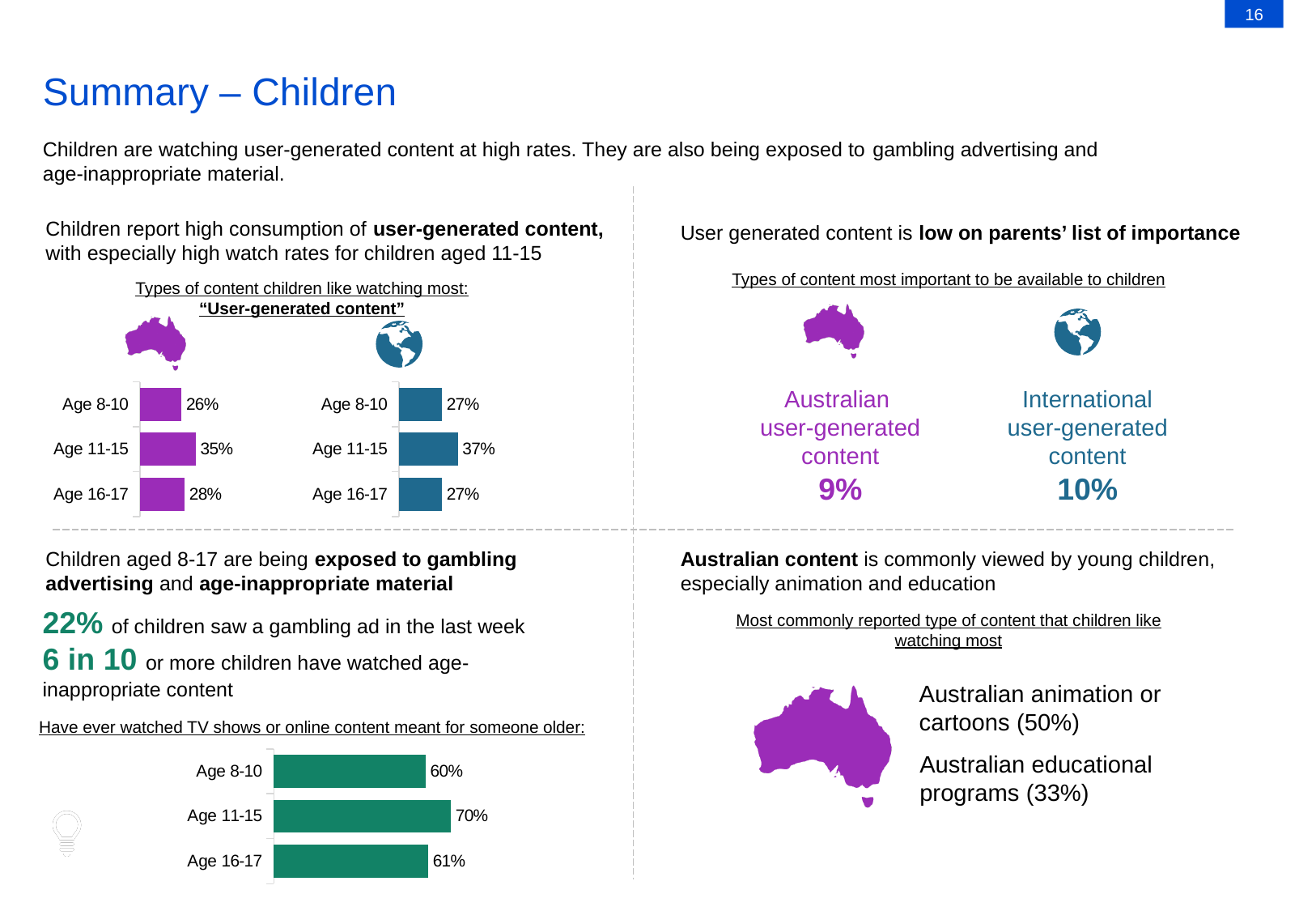
In the purple Australian user-generated content chart (top left), what is the difference between Age 11-15 and Age 8-10? 9 percentage points In the blue international user-generated content chart (top left), what is the value for Age 16-17? 27% In the blue international user-generated content chart (top left), which age group has the highest value? Age 11-15 In the 'Have ever watched TV shows or online content meant for someone older' chart (bottom left), which is larger, Age 16-17 or Age 8-10? Age 16-17 How many age groups are shown in the 'Have ever watched TV shows or online content meant for someone older' chart (bottom left)? 3 What kind of chart is the 'Have ever watched TV shows or online content meant for someone older' chart (bottom left)? Bar chart In the 'Have ever watched TV shows or online content meant for someone older' chart (bottom left), what is the value for Age 8-10? 60% In the purple Australian user-generated content chart (top left), what is the value for Age 11-15? 35% In the blue international user-generated content chart (top left), what is the value for Age 11-15? 37% In the purple Australian user-generated content chart (top left), which age group has the lowest value? Age 8-10 In the 'Have ever watched TV shows or online content meant for someone older' chart (bottom left), what is the difference between Age 11-15 and Age 16-17? 9 percentage points In the 'Have ever watched TV shows or online content meant for someone older' chart (bottom left), which age group has the highest value? Age 11-15